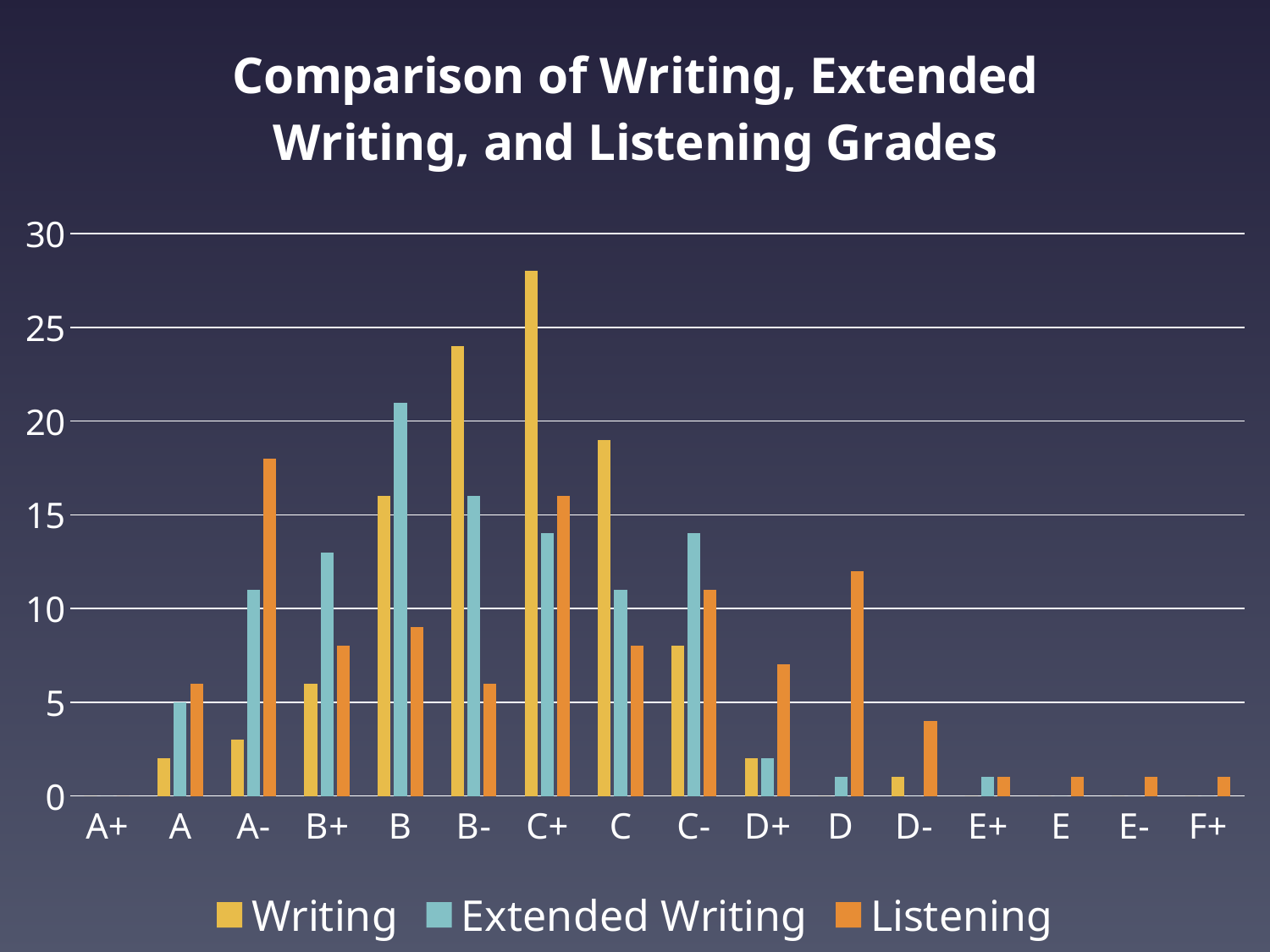
For grade B, which is larger: the Writing value or the Listening value? Writing Which grade has the highest Listening value? A- Which grade has the highest Writing value? C+ Is the Listening value for A- greater or less than 15? greater Is the Writing value for C+ greater or less than 25? greater Which series is the only one with a bar at F+? Listening How many series does the legend list? 3 How many grade categories are shown on the x axis? 16 For grade D, which is larger: the Extended Writing value or the Listening value? Listening Is the Extended Writing value for B greater or less than 20? greater Which grade has the highest Extended Writing value? B What kind of chart is shown on the slide? Bar chart